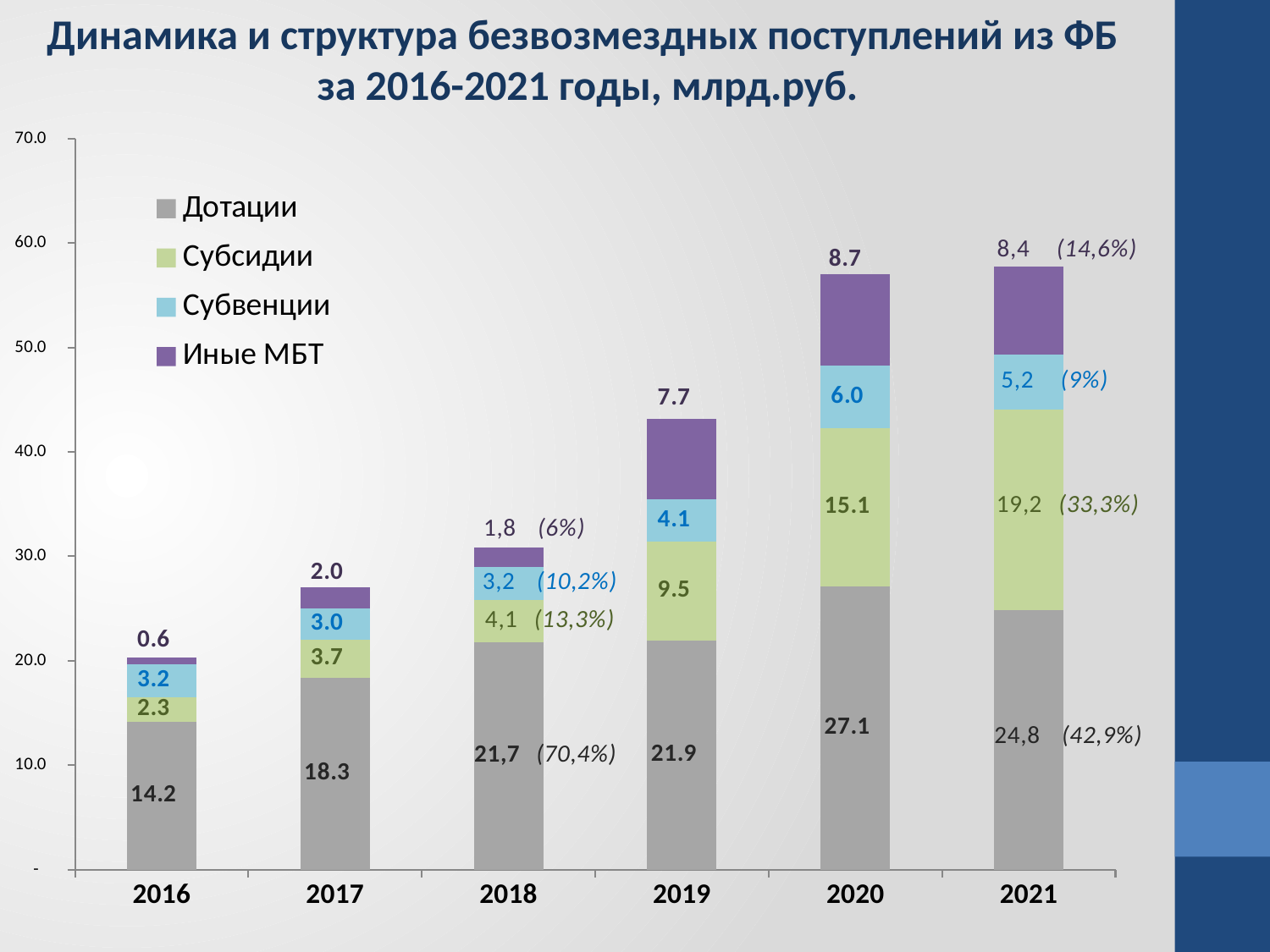
What is the total of the stacked bar for 2017? 27.0 How many years are shown on the x axis? 6 What is the value of Иные МБТ for 2016? 0.6 What is the difference between the Субсидии values for 2020 and 2019? 5.6 Which is larger, the Субвенции value for 2020 or for 2021? 2020 What is the value of Субсидии for 2021? 19,2 In which year is the Иные МБТ value the lowest? 2016 In which year is the Дотации value the highest? 2020 What kind of chart is shown on the slide? Stacked bar chart How many series does the legend list? 4 What percentage share is shown next to the Дотации value for 2018? 70,4% What is the value of Дотации for 2020? 27.1